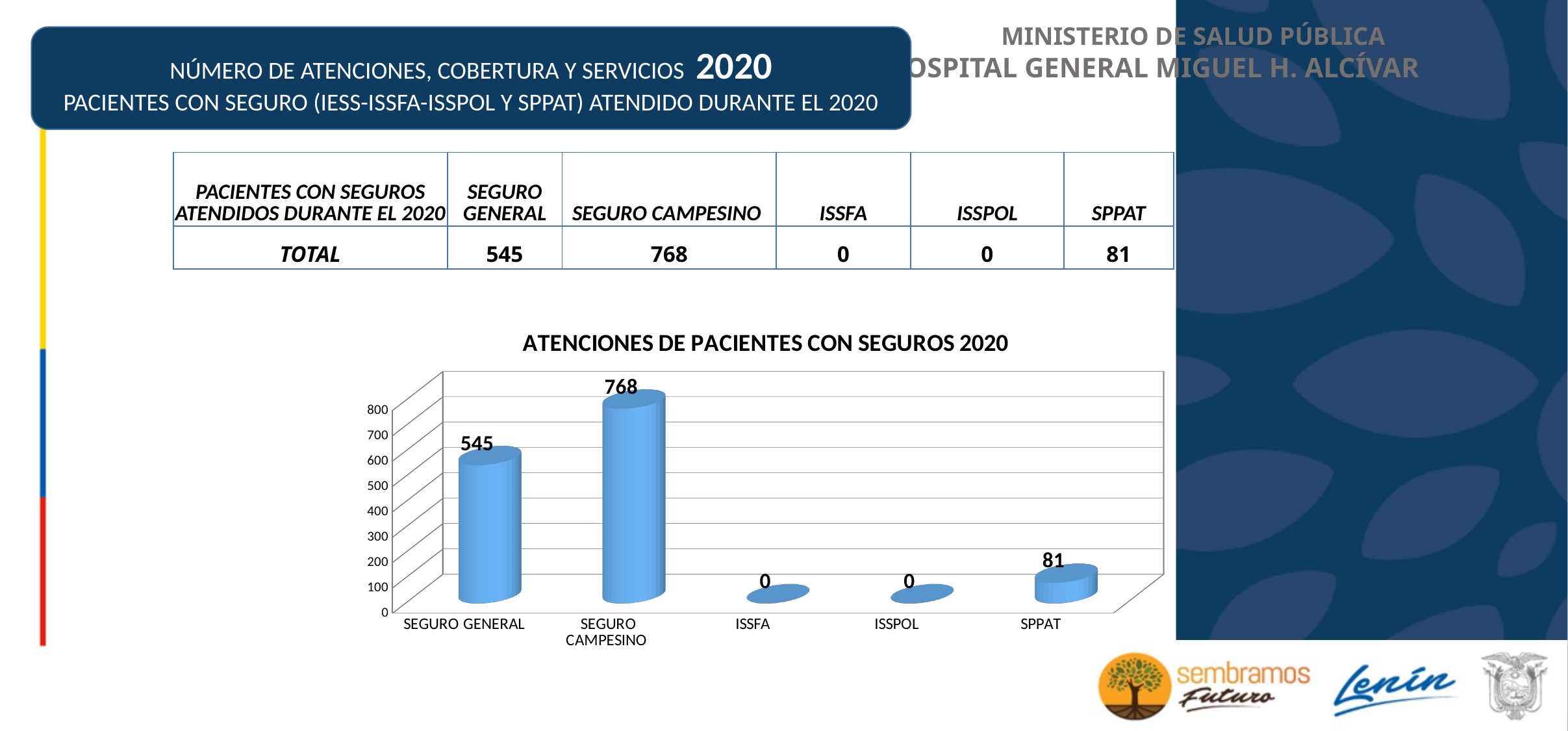
How many categories are shown on the x axis of the chart? 5 What is the value for SEGURO GENERAL in the chart? 545 What is the title of the chart? ATENCIONES DE PACIENTES CON SEGUROS 2020 What is the difference between the values for SEGURO CAMPESINO and SEGURO GENERAL? 223 Which is larger, the value for SEGURO GENERAL or the value for SPPAT? SEGURO GENERAL What kind of chart is shown on the slide? bar chart Is the value for SEGURO GENERAL greater or less than 500? greater What is the value for ISSFA in the chart? 0 What is the value for SPPAT in the chart? 81 What is the value for SEGURO CAMPESINO in the chart? 768 Which category has the highest value in the chart? SEGURO CAMPESINO What is the difference between the values for SEGURO GENERAL and SPPAT? 464